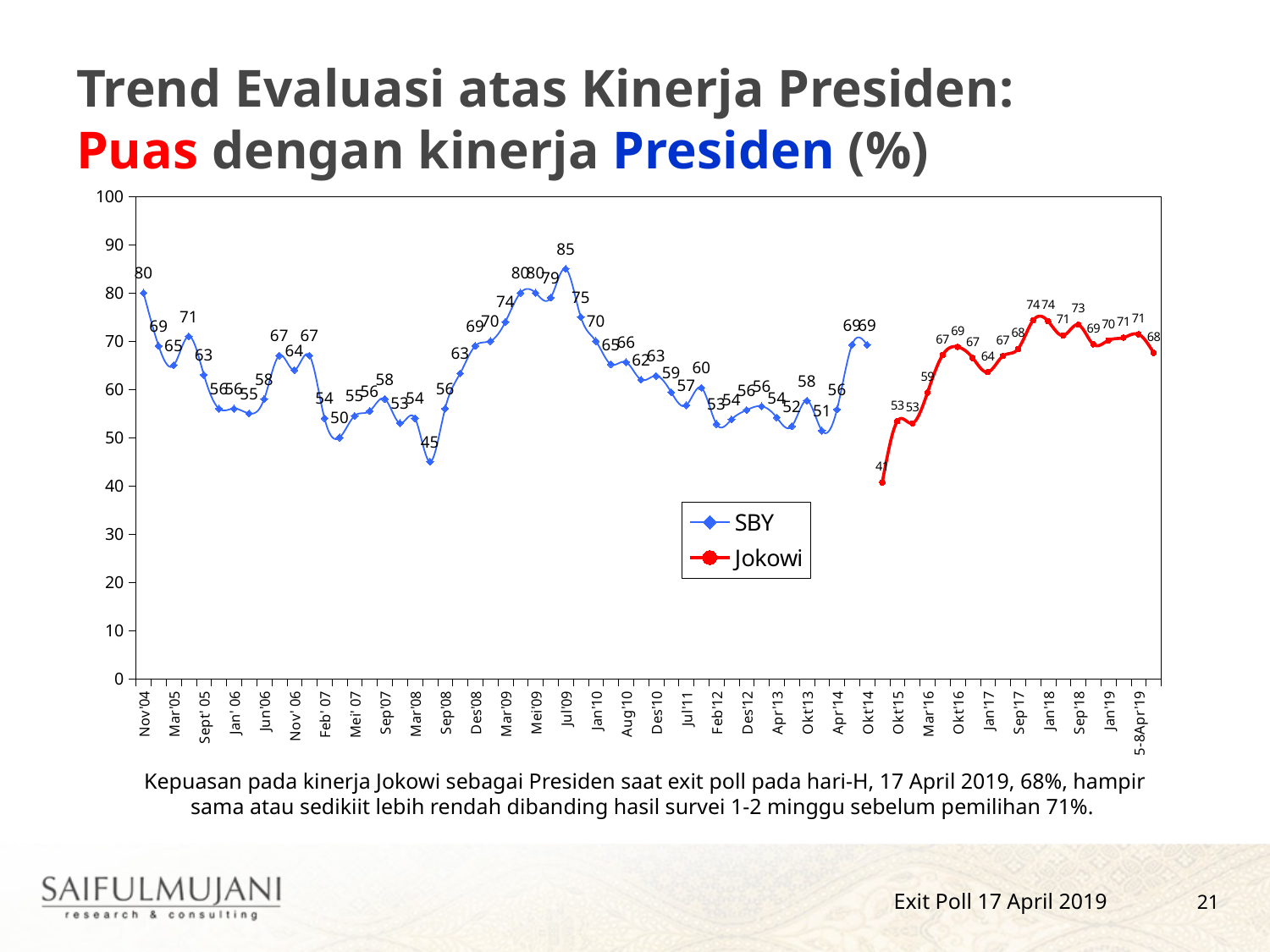
What are the two series named in the legend? SBY and Jokowi What is the highest value reached by the SBY series? 85 Which series reaches a higher peak value, SBY or Jokowi? SBY What is the difference between the highest and lowest values of the SBY series? 40 What is the value of the SBY series at the first point, Nov'04? 80 What is the lowest value reached by the Jokowi series? 41 How many series does the legend list? 2 What is the highest value reached by the Jokowi series? 74 What type of chart is shown on the slide? Line chart What colour is the Jokowi line? Red What is the lowest value reached by the SBY series? 45